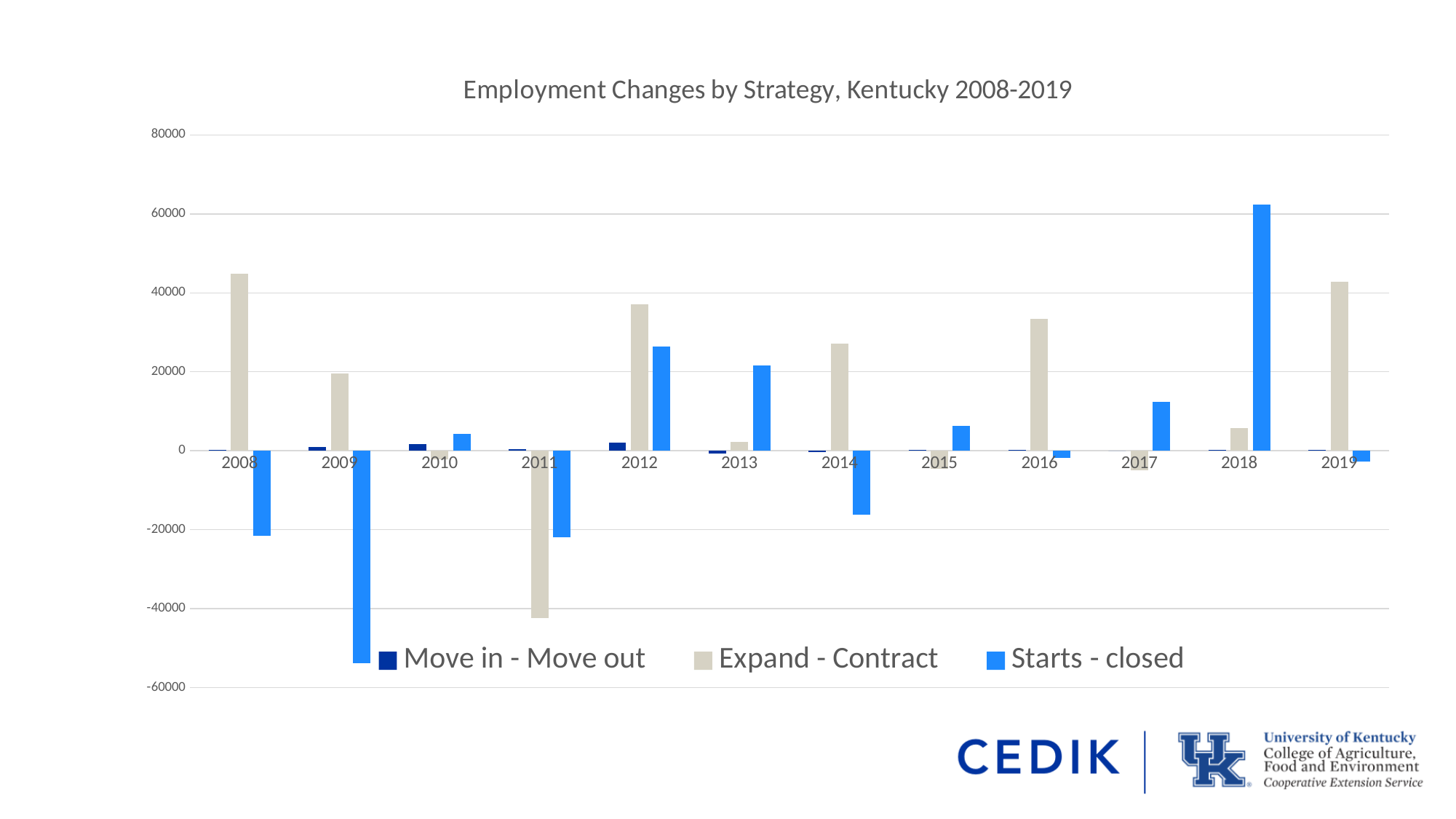
Is the Starts - closed value for 2009 greater or less than -40000? less In 2013, which is larger: Expand - Contract or Starts - closed? Starts - closed How many years are shown on the x axis? 12 In which year is the Starts - closed value lowest? 2009 Is the Starts - closed value for 2018 greater or less than 60000? greater What kind of chart is shown on the slide? bar chart How many series does the legend list? 3 What is the title of the chart? Employment Changes by Strategy, Kentucky 2008-2019 In which year is the Expand - Contract value lowest? 2011 In 2012, which is larger: Expand - Contract or Starts - closed? Expand - Contract Is the Expand - Contract value for 2011 greater or less than -40000? less In which year is the Starts - closed value highest? 2018